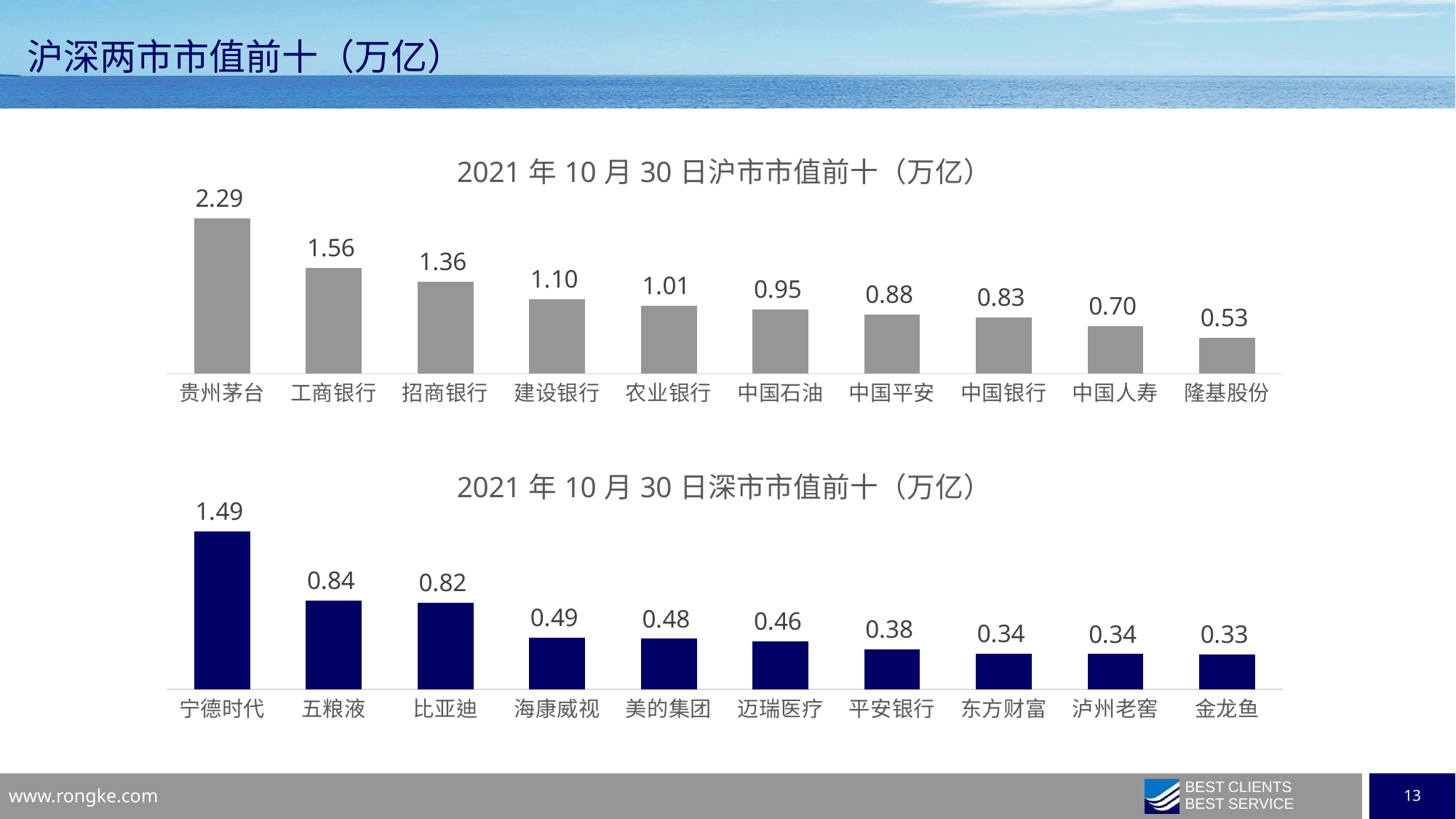
How many companies are shown in the bottom chart (深市市值前十)? 10 What type of chart is the top chart (沪市市值前十)? Bar chart In the bottom chart (深市市值前十), what is the value for 海康威视? 0.49 In the bottom chart (深市市值前十), do the values rise or fall from left to right? Fall In the bottom chart (深市市值前十), which company has the highest value? 宁德时代 In the top chart (沪市市值前十), what is the difference between 工商银行 and 招商银行? 0.20 In the top chart (沪市市值前十), what is the value for 中国平安? 0.88 In the top chart (沪市市值前十), which is larger, 建设银行 or 中国石油? 建设银行 In the bottom chart (深市市值前十), what is the difference between 宁德时代 and 五粮液? 0.65 In the bottom chart (2021年10月30日深市市值前十), what is the value for 宁德时代? 1.49 In the top chart (2021年10月30日沪市市值前十), what is the value for 贵州茅台? 2.29 In the top chart (沪市市值前十), which company has the lowest value? 隆基股份